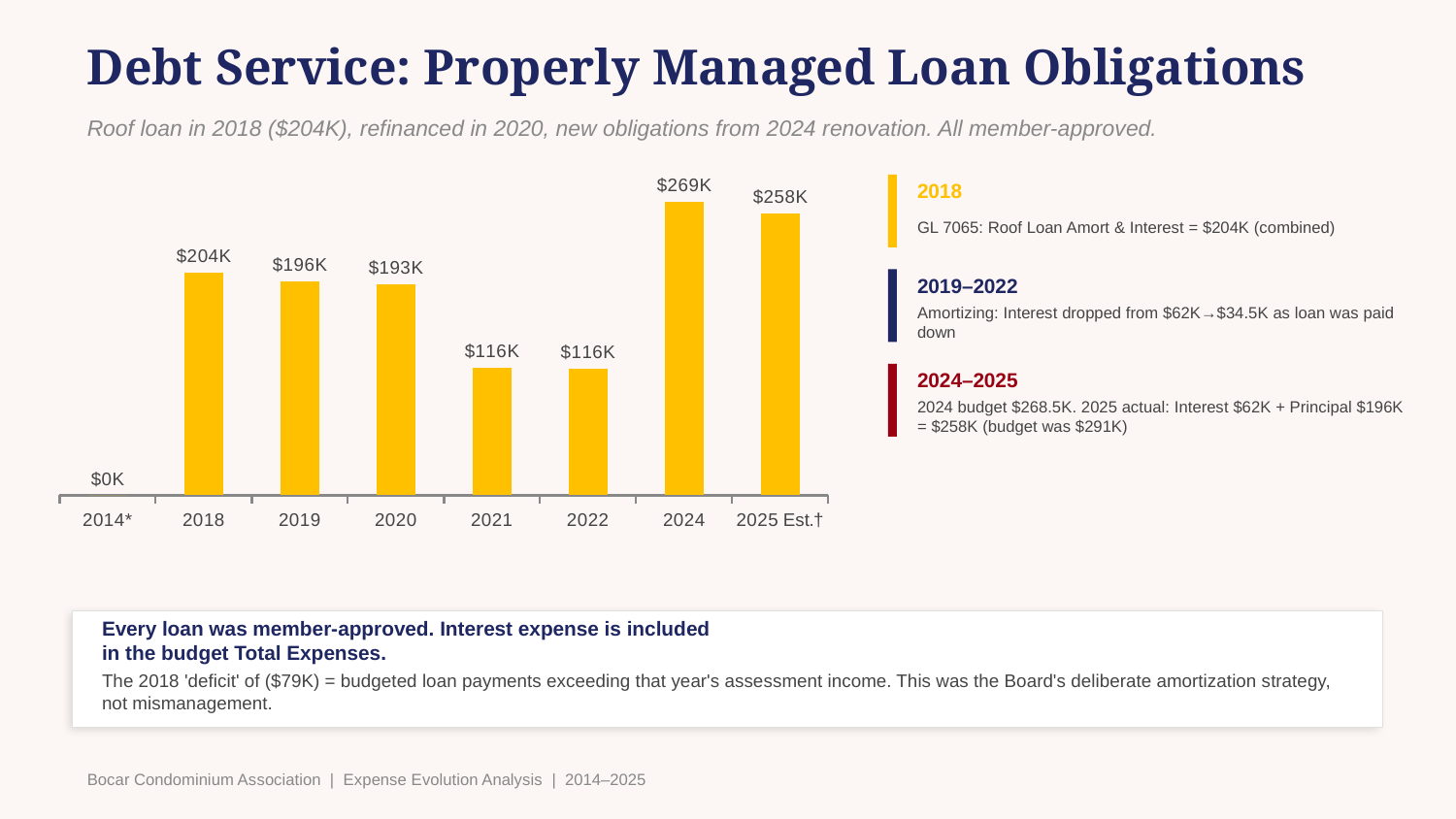
Which is larger, the value for 2018 or the value for 2025 Est.†? 2025 Est.† What kind of chart is shown on the slide? Bar chart Which category has the lowest value in the chart? 2014* How many categories are shown on the x axis of the chart? 8 What is the value shown for 2025 Est.†? $258K What is the value shown for 2021? $116K Do the values rise or fall from 2018 through 2022? Fall What is the difference between the values for 2020 and 2021? $77K What colour are the bars in the chart? Yellow What is the value shown for 2018? $204K What is the difference between the values for 2024 and 2025 Est.†? $11K Which year has the highest value in the chart? 2024